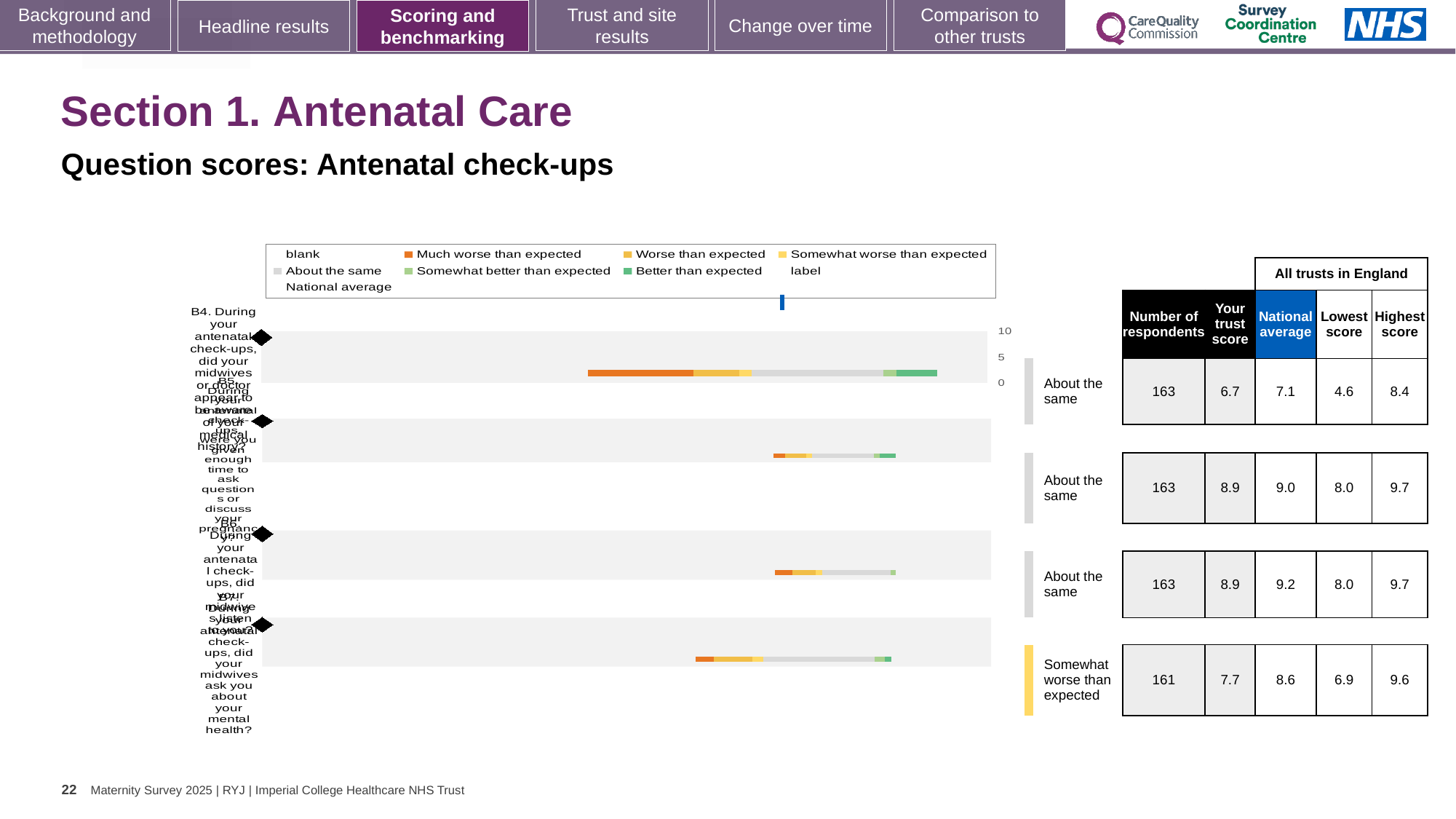
How many question bars are plotted in the chart? 4 For the bottom bar (B7), what is the difference between the national average and the trust score? 0.9 For the top bar (B4), what is the difference between the highest score and the lowest score across all trusts in England? 3.8 What is the number of respondents for the top bar (B4) in the table beside the chart? 163 What kind of chart is shown on the slide? bar chart What is the trust score for the bottom bar (B7) in the table beside the chart? 7.7 In the chart legend, what colour represents 'Much worse than expected'? orange For the bottom bar (B7), which is larger: the trust score or the national average? national average What is the lowest score across all trusts in England for the top bar (B4)? 4.6 In the chart legend, what colour represents 'Better than expected'? green Which bar has the lowest 'Your trust score' in the table beside the chart? the top bar (B4) What is the national average for the third bar (B6) in the table beside the chart? 9.2